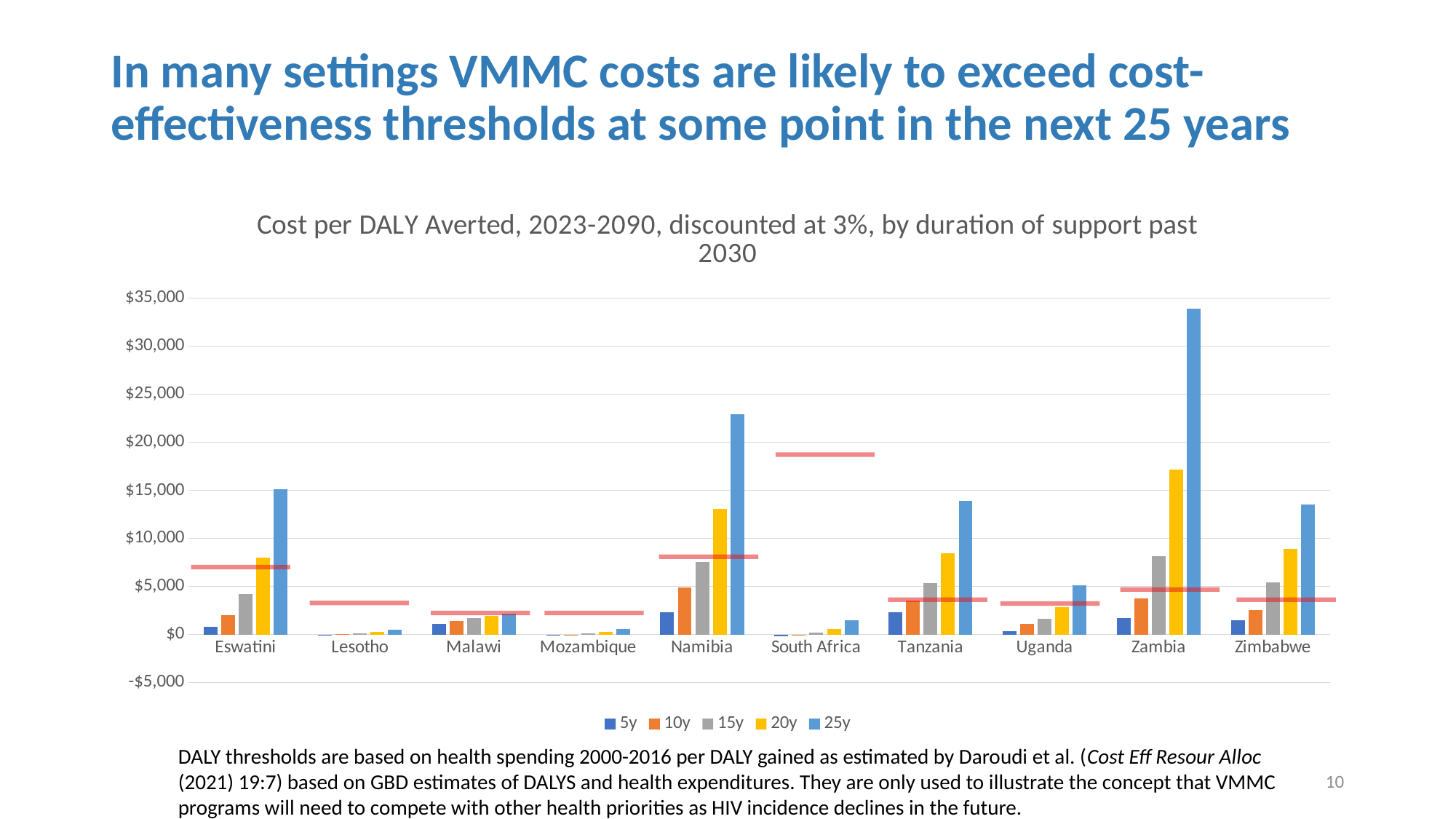
Which is larger, the 20y value for Zambia or the 20y value for Namibia? Zambia Is the 20y value for Zambia greater or less than $15,000? greater Is the 25y value for Uganda greater or less than $10,000? less What kind of chart is shown on the slide? Bar chart Is the 25y value for Namibia greater or less than $20,000? greater Which country has the highest 25y bar in the chart? Zambia How many countries are shown on the x axis of the chart? 10 Within each country, do the bars rise or fall as the duration of support goes from 5y to 25y? rise Which is larger, the 25y value for Namibia or the 25y value for Tanzania? Namibia How many series does the chart's legend list? 5